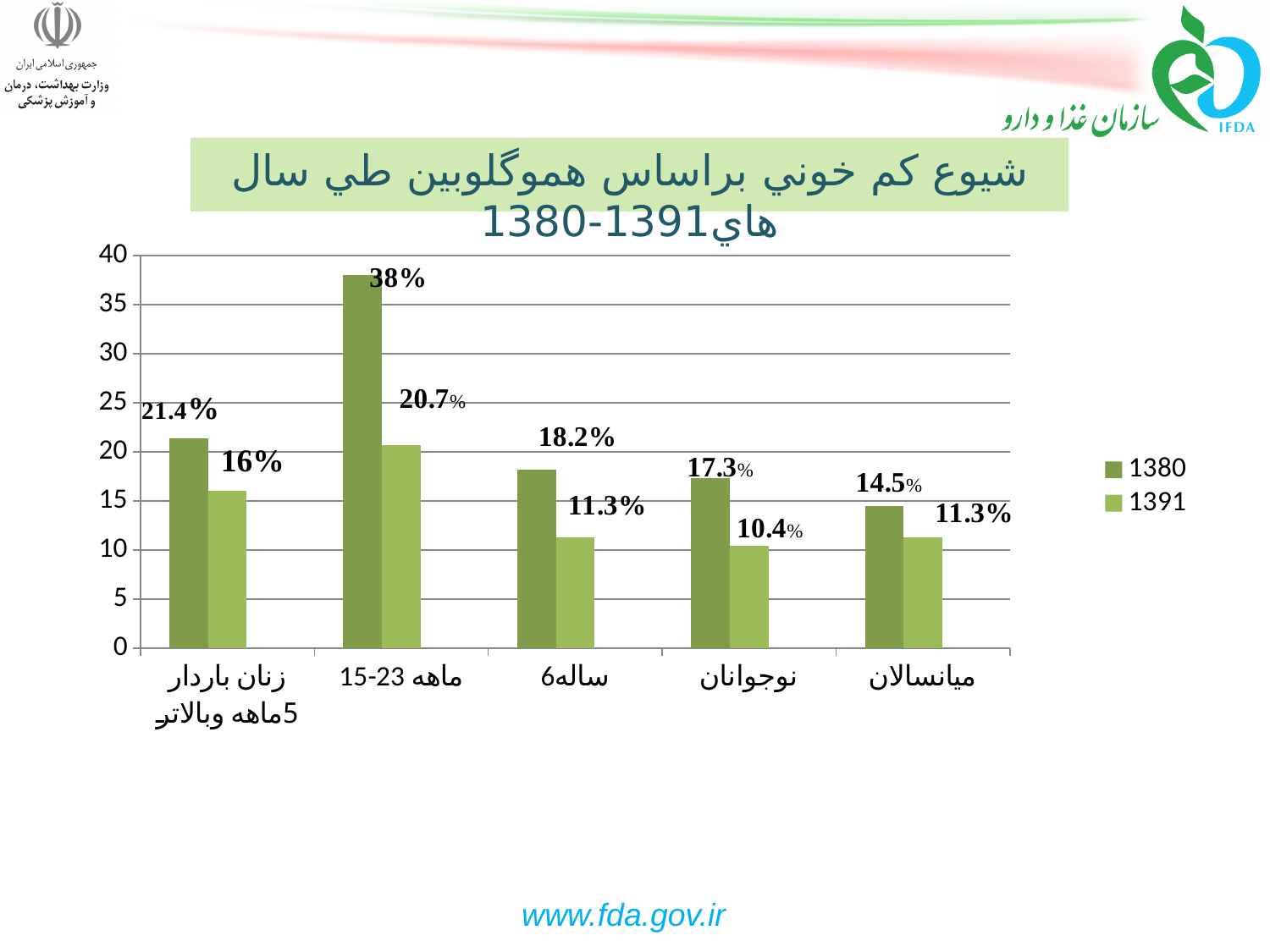
Which is larger in the 6ساله category: the 1380 value or the 1391 value? 1380 Does every category show a decrease from 1380 to 1391? yes Which series is shown in the darker green colour? 1380 Which category has the highest value for the 1380 series? 15-23 ماهه What is the value for the 1380 series in the 15-23 ماهه category? 38% How many categories are shown on the x axis? 5 What is the value for the 1391 series in the نوجوانان category? 10.4% How many series does the legend list? 2 What kind of chart is shown on the slide? bar chart Which category has the lowest value for the 1391 series? نوجوانان What is the difference between the 1380 and 1391 values in the 15-23 ماهه category? 17.3% What is the value for the 1380 series in the میانسالان category? 14.5%